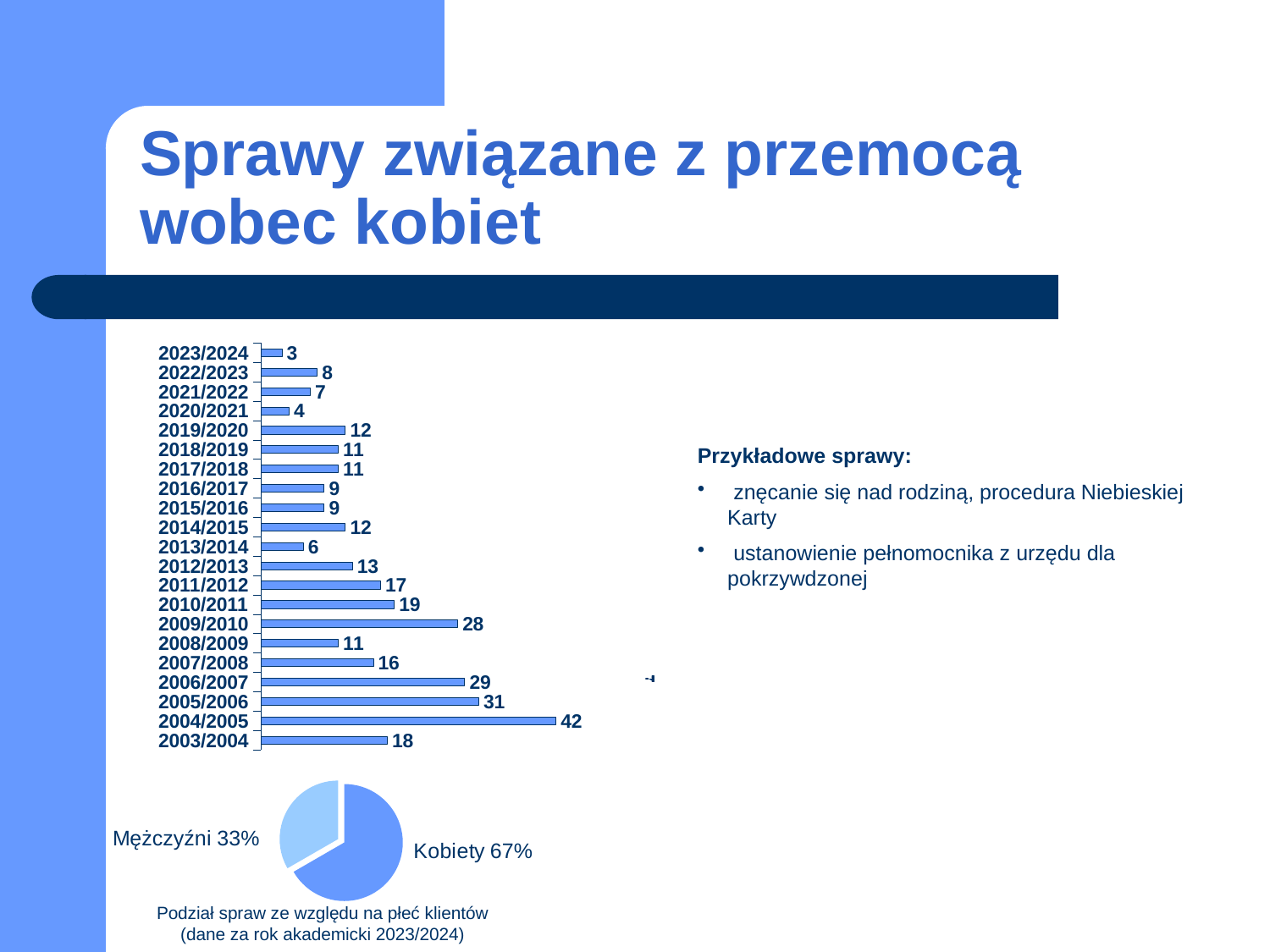
How many academic years are shown in the bar chart? 21 In the bar chart, which academic year has the highest value? 2004/2005 In the bar chart, what is the value for 2023/2024? 3 In the bar chart, which is larger, the value for 2010/2011 or the value for 2011/2012? 2010/2011 In the bar chart, what is the value for 2004/2005? 42 In the bar chart, which academic year has the lowest value? 2023/2024 In the bar chart, what is the value for 2009/2010? 28 What type of chart shows the values by academic year? Bar chart In the bar chart, what is the difference between the values for 2005/2006 and 2006/2007? 2 What is the caption of the pie chart at the bottom of the slide? Podział spraw ze względu na płeć klientów (dane za rok akademicki 2023/2024) In the pie chart at the bottom, what share is Kobiety? 67% In the pie chart at the bottom, what share is Mężczyźni? 33%